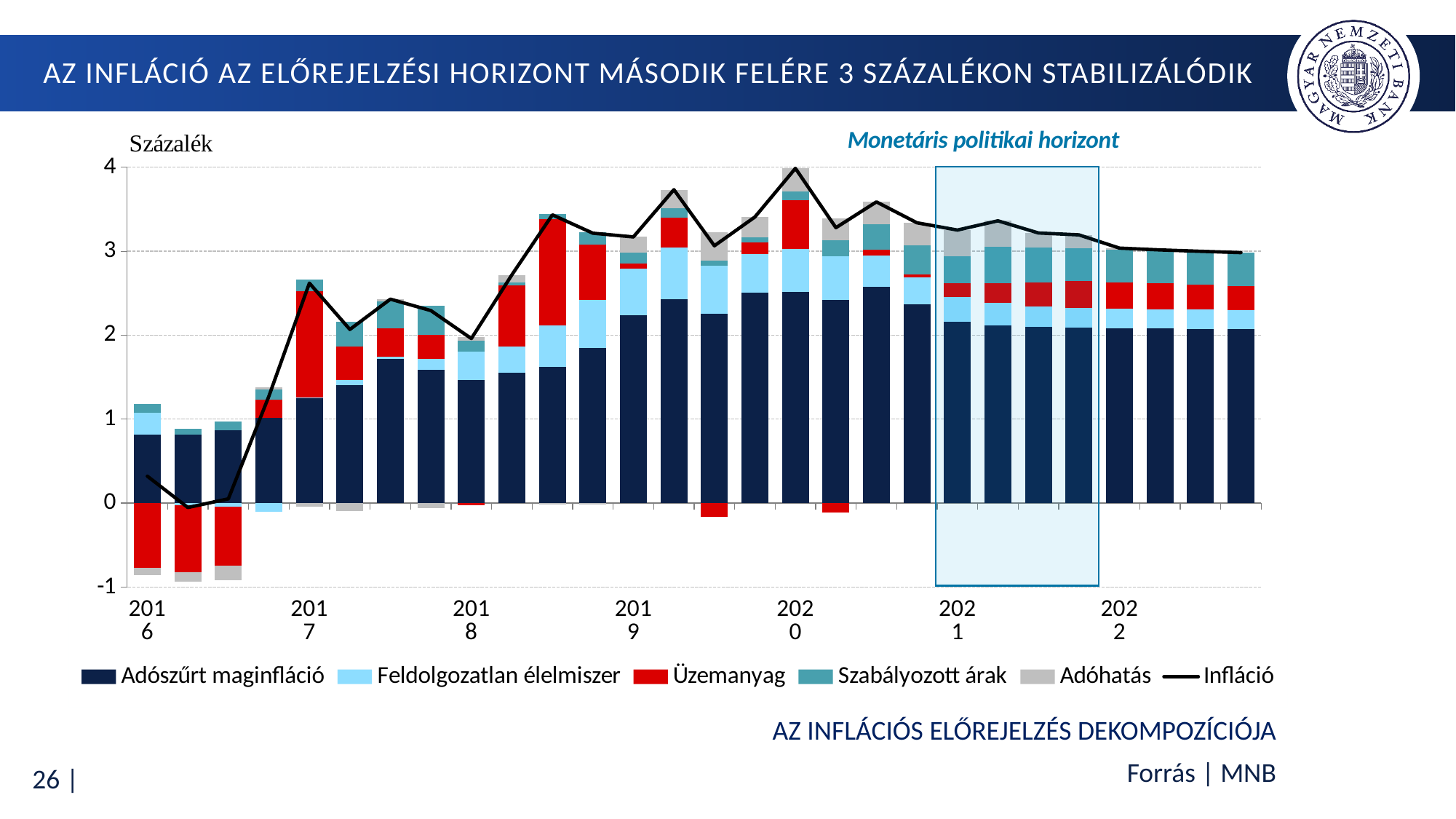
How many series does the legend list? 6 In which year does the Infláció line reach its lowest point? 2016 Is the value of the Infláció line at the start of 2017 greater or less than 2? greater How many year labels are shown on the x axis? 7 What kind of chart is shown on the slide? Stacked bar chart with a line Is the Adószűrt maginfláció contribution in the first bar of 2020 greater or less than 2? greater What unit label is shown above the y axis? Százalék Is the value of the Infláció line at the start of 2021 greater or less than 3? greater In which year does the Infláció line reach its highest point? 2020 Does the Infláció line rise or fall between the start of 2016 and the start of 2017? rise